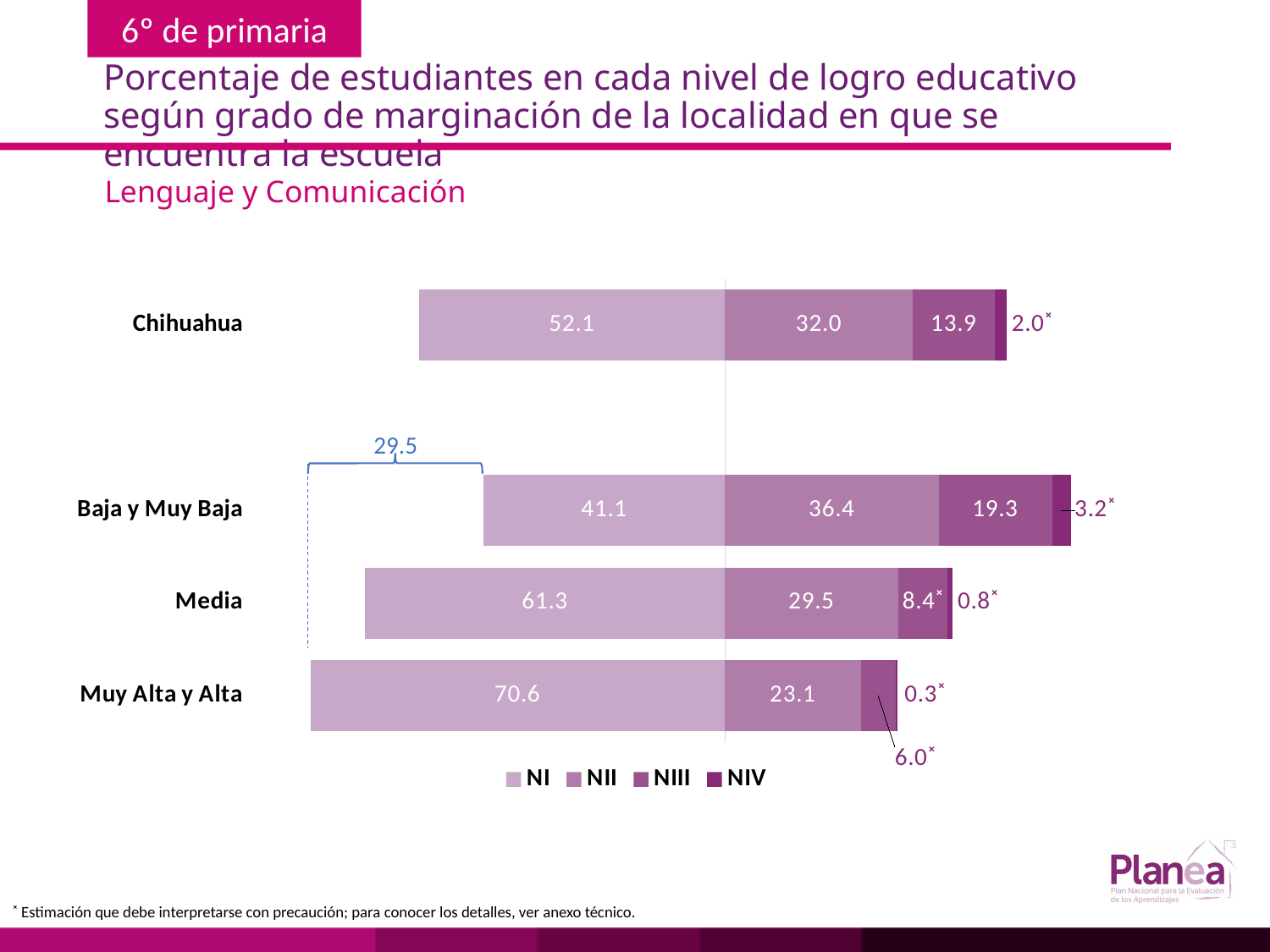
What is the NI value for Muy Alta y Alta? 70.6 Which category has the highest NI value? Muy Alta y Alta What is the NII value for Baja y Muy Baja? 36.4 Which is larger, the NII value for Chihuahua or the NII value for Media? Chihuahua What is the NI value for Chihuahua? 52.1 Which category has the lowest NI value? Baja y Muy Baja What is the NIII value for Chihuahua? 13.9 What are the legend entries of the chart, in order? NI, NII, NIII, NIV What is the difference between the NI values for Media and Baja y Muy Baja? 20.2 What type of chart is shown on the slide? Stacked bar chart How many series does the legend list? 4 How many categories (bars) are plotted in the chart? 4